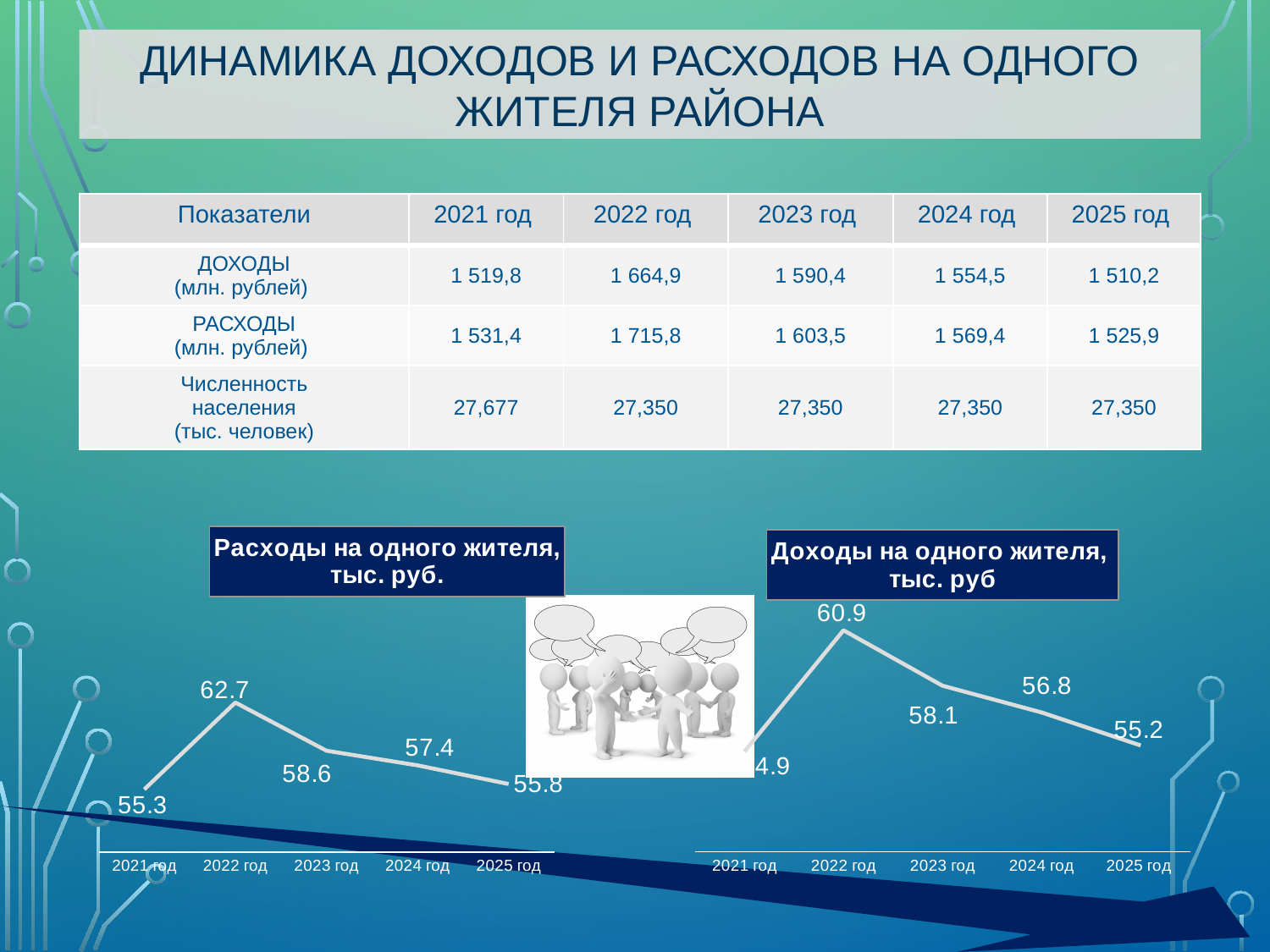
In the 'Расходы на одного жителя, тыс. руб.' chart, what is the value for 2025 год? 55.8 In the 'Расходы на одного жителя, тыс. руб.' chart, which year has the lowest value? 2021 год In the 'Расходы на одного жителя, тыс. руб.' chart, how many years are plotted? 5 In the 'Расходы на одного жителя, тыс. руб.' chart, which year has the highest value? 2022 год In the 'Доходы на одного жителя, тыс. руб' chart, do the values rise or fall from 2022 год to 2025 год? fall In the 'Расходы на одного жителя, тыс. руб.' chart, what is the value for 2022 год? 62.7 In the 'Расходы на одного жителя, тыс. руб.' chart, what is the difference between the values for 2022 год and 2023 год? 4.1 In the 'Доходы на одного жителя, тыс. руб' chart, what is the value for 2022 год? 60.9 In the 'Доходы на одного жителя, тыс. руб' chart, what is the value for 2024 год? 56.8 In the 'Доходы на одного жителя, тыс. руб' chart, which year has the highest value? 2022 год What type of chart is the 'Расходы на одного жителя, тыс. руб.' chart? line chart In the 'Доходы на одного жителя, тыс. руб' chart, which is larger, the value for 2023 год or 2025 год? 2023 год